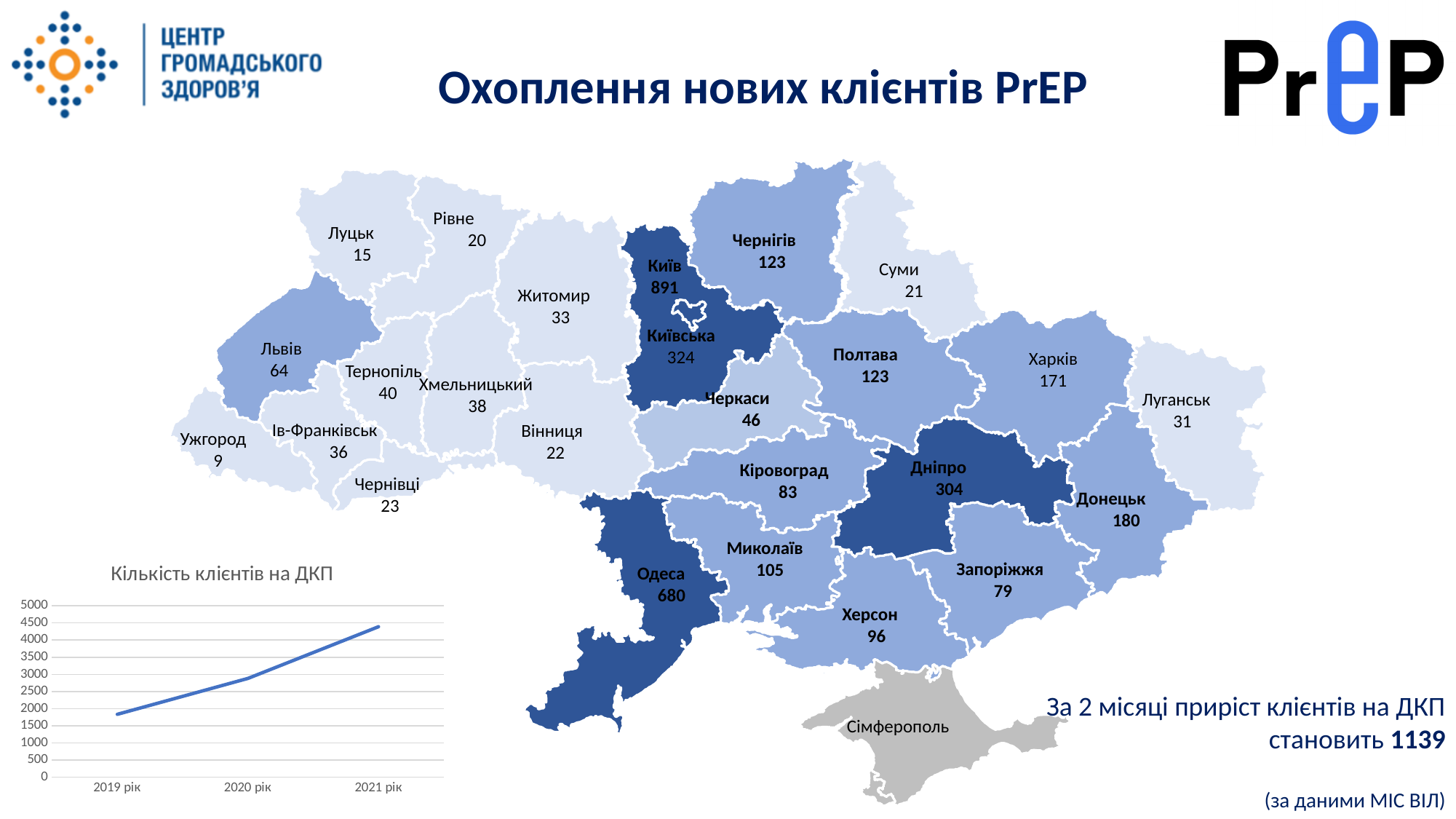
On the line chart "Кількість клієнтів на ДКП", is the value for 2019 рік greater or less than 2000? less On the line chart "Кількість клієнтів на ДКП", is the value for 2020 рік greater or less than 2500? greater How many data points are plotted on the line chart "Кількість клієнтів на ДКП"? 3 On the map of Ukraine, what value is shown for Київ? 891 What is the title of the line chart in the lower left of the slide? Кількість клієнтів на ДКП On the line chart "Кількість клієнтів на ДКП", which year has the highest value? 2021 рік On the line chart "Кількість клієнтів на ДКП", do the values rise or fall from 2019 рік to 2021 рік? rise On the map of Ukraine, what is the difference between the values for Київ and Одеса? 211 On the line chart "Кількість клієнтів на ДКП", is the value for 2021 рік greater or less than 4000? greater On the map of Ukraine, which region has the lowest value? Ужгород What kind of chart is the chart titled "Кількість клієнтів на ДКП"? line chart On the line chart "Кількість клієнтів на ДКП", which year has the lowest value? 2019 рік